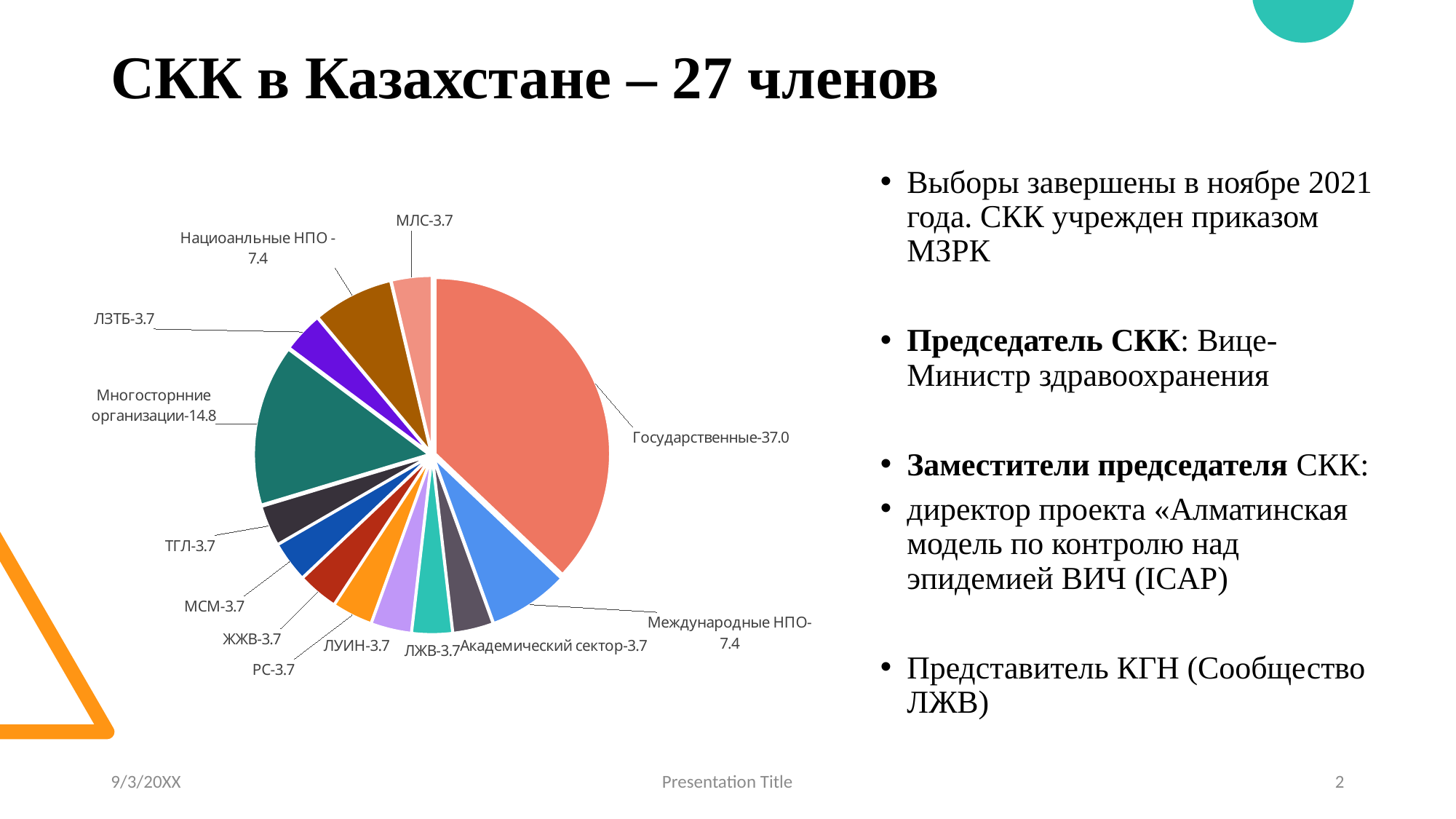
What is the difference between the values for Государственные and Многосторнние организации? 22.2 What is the title of the slide containing the pie chart? СКК в Казахстане – 27 членов Which is larger, the slice for Многосторнние организации or the slice for Национальные НПО? Многосторнние организации What value is shown for Национальные НПО in the pie chart? 7.4 How many slices does the pie chart have? 13 What value is shown for МСМ in the pie chart? 3.7 What value is shown for Международные НПО in the pie chart? 7.4 What value is shown for Многосторнние организации in the pie chart? 14.8 What value is shown for Государственные in the pie chart? 37.0 What is the difference between the values for Многосторнние организации and Международные НПО? 7.4 What kind of chart is shown on the slide? pie chart Which category has the largest slice in the pie chart? Государственные